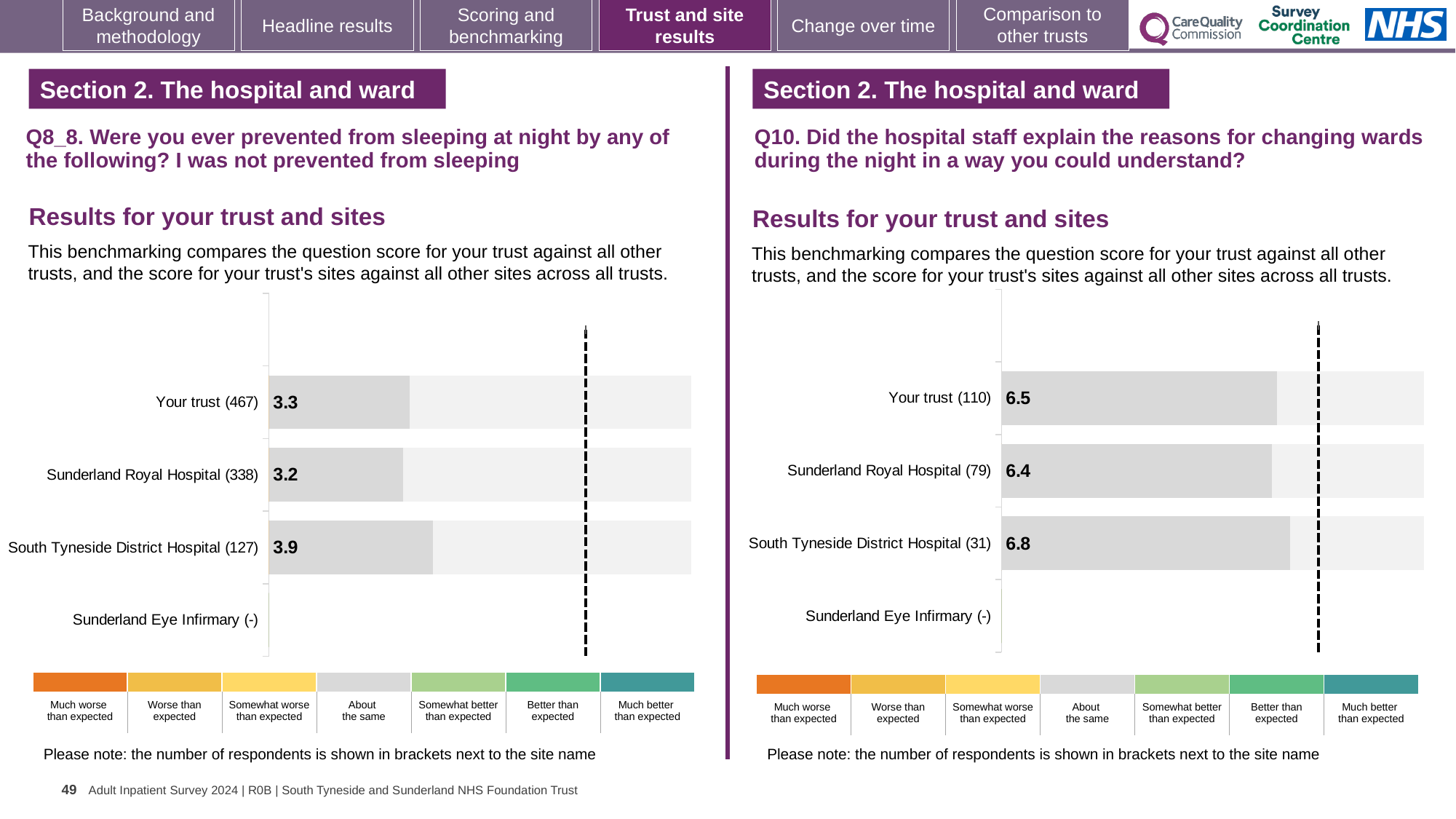
On the Q8_8 chart (left), how many respondents are shown in brackets for Your trust? 467 On the Q8_8 chart (left), what is the score for South Tyneside District Hospital? 3.9 On the Q10 chart (right), what is the score for Sunderland Royal Hospital? 6.4 On the Q10 chart (right), what is the difference between the scores for South Tyneside District Hospital and Your trust? 0.3 On the Q10 chart (right), is the score for Your trust larger or smaller than the score for Sunderland Royal Hospital? larger On the Q10 chart (right), which site has no score shown (marked with a dash)? Sunderland Eye Infirmary On the Q8_8 chart (left), which site or trust has the lowest score? Sunderland Royal Hospital On the Q8_8 chart (left), what is the score for Your trust? 3.3 What kind of chart is used on the Q8_8 chart (left)? bar chart On the Q10 chart (right), which site or trust has the highest score? South Tyneside District Hospital On the Q10 chart (right), how many respondents are shown in brackets for South Tyneside District Hospital? 31 On the Q8_8 chart (left), what is the difference between the scores for South Tyneside District Hospital and Sunderland Royal Hospital? 0.7